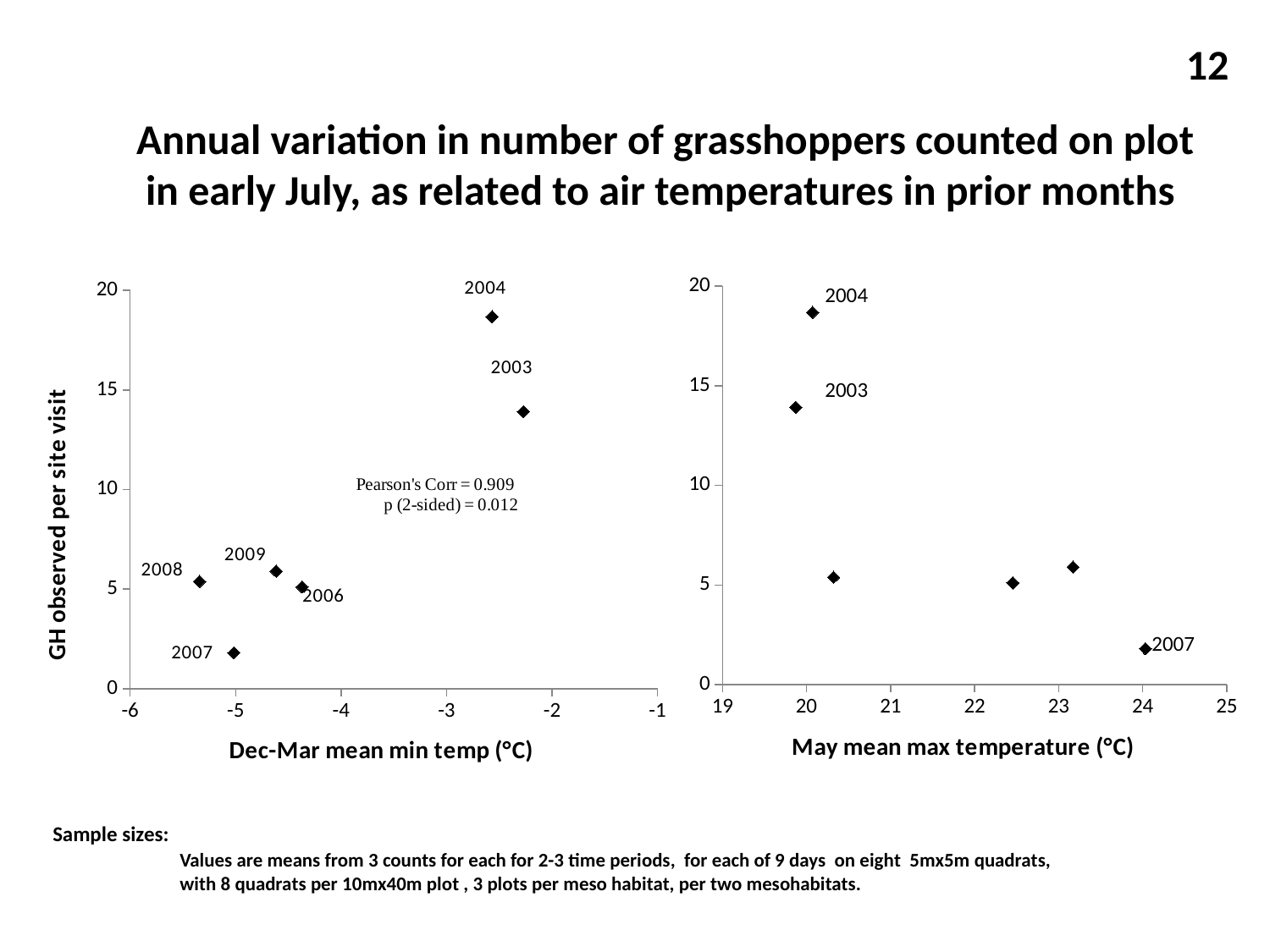
What Pearson's correlation value is printed on the left chart (Dec-Mar mean min temp)? 0.909 In the left chart (Dec-Mar mean min temp), which year has more grasshoppers observed per site visit, 2003 or 2008? 2003 In the left chart (Dec-Mar mean min temp), do grasshopper counts generally rise or fall as the Dec-Mar mean min temperature increases? rise In the right chart (May mean max temperature), which labelled year has the highest number of grasshoppers observed per site visit? 2004 In the left chart (Dec-Mar mean min temp), which year has the highest number of grasshoppers observed per site visit? 2004 In the right chart (May mean max temperature), which labelled year has the lowest number of grasshoppers observed per site visit? 2007 What kind of chart is the left chart (Dec-Mar mean min temp)? Scatter chart In the left chart (Dec-Mar mean min temp), which year has the lowest number of grasshoppers observed per site visit? 2007 In the left chart (Dec-Mar mean min temp), is the value for 2004 greater or less than 15? greater In the left chart (Dec-Mar mean min temp), is the value for 2007 greater or less than 5? less How many data points are plotted in the left chart (Dec-Mar mean min temp)? 6 How many data points are plotted in the right chart (May mean max temperature)? 6